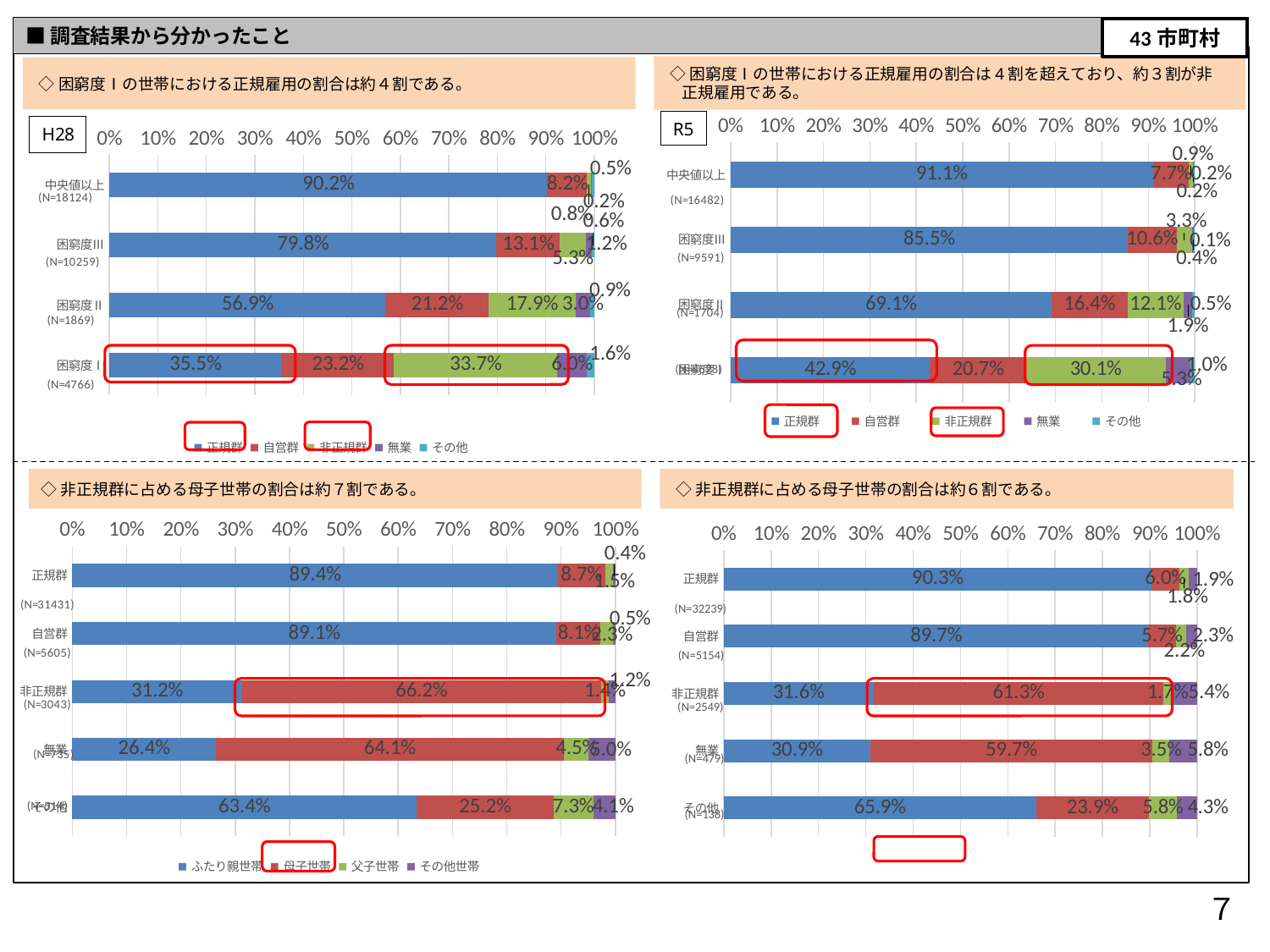
What kind of chart is the bottom-left chart? Stacked bar chart In the top-right R5 chart, what is the difference between the 正規群 share for 中央値以上 and for 困窮度Ⅰ? 48.2% In the top-left H28 chart, how many series does the legend list? 5 In the bottom-right chart, which is larger: the ふたり親世帯 share for 正規群 or for 自営群? 正規群 In the top-left H28 chart, what is the 正規群 share for 困窮度Ⅰ? 35.5% In the bottom-left chart, how many series does the legend list? 4 In the bottom-left chart, how many categories are shown on the vertical axis? 5 In the top-right R5 chart, which category has the lowest 正規群 share? 困窮度Ⅰ In the top-left H28 chart, which category has the highest 正規群 share? 中央値以上 In the bottom-right chart, what is the 母子世帯 share for 非正規群? 61.3% In the bottom-left chart, what is the 母子世帯 share for 非正規群? 66.2% In the top-right R5 chart, what is the 非正規群 share for 困窮度Ⅰ? 30.1%